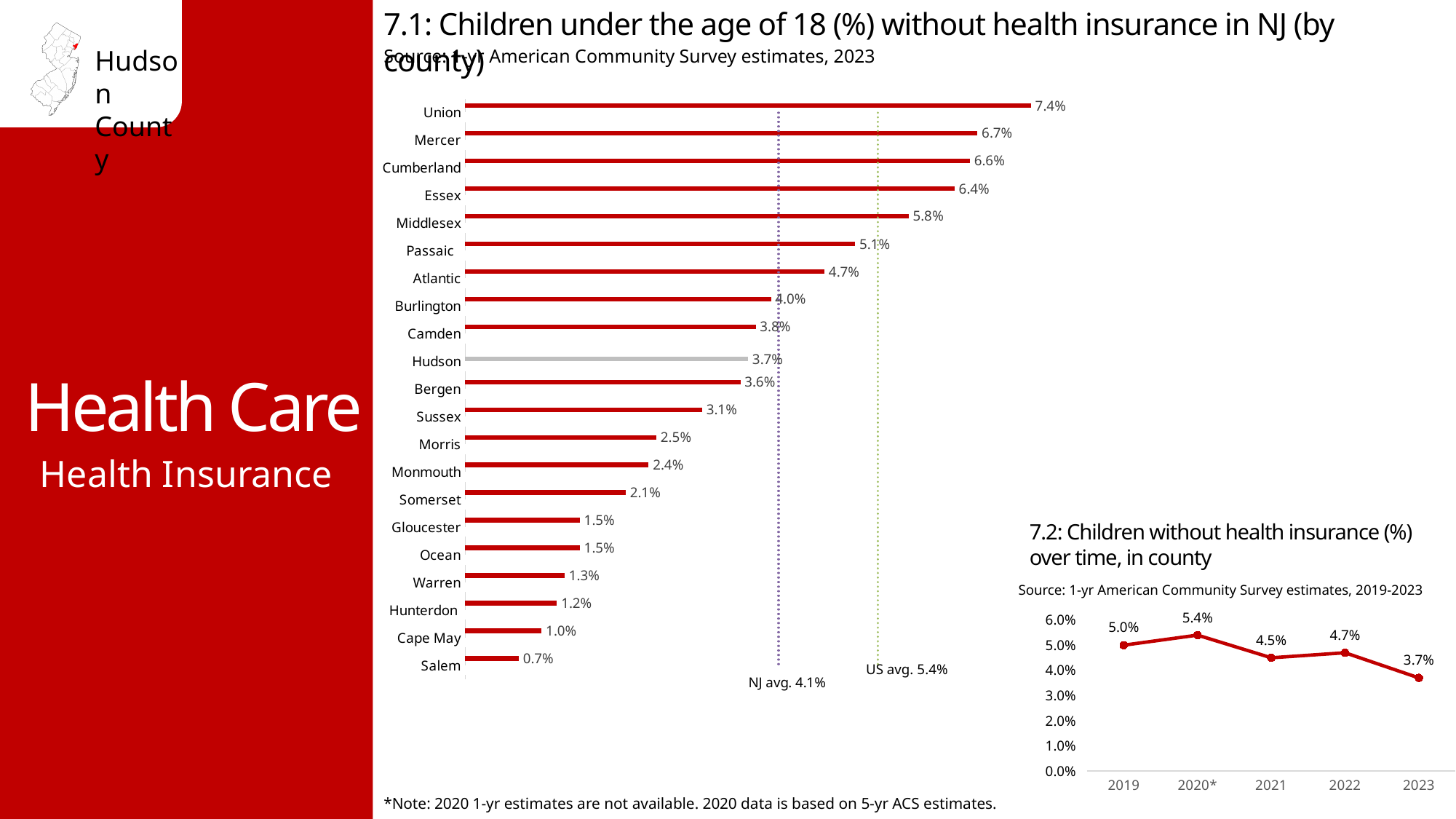
In chart 7.1, which county has the lowest percentage of children without health insurance? Salem In chart 7.1, which county has the highest percentage of children without health insurance? Union What kind of chart is chart 7.1? Bar chart In chart 7.1, what is the value for Passaic? 5.1% In chart 7.1 (children under 18 without health insurance by county), what is the value for Hudson? 3.7% In chart 7.2 (children without health insurance over time in county), what is the value for 2021? 4.5% In chart 7.1, what is the difference between the values for Union and Salem? 6.7% In chart 7.1, what NJ average value is marked by the dotted reference line? 4.1% In chart 7.1, which county has a larger value, Essex or Middlesex? Essex In chart 7.2, which year has the highest value? 2020* In chart 7.1, how many counties are shown? 21 In chart 7.2, what is the difference between the 2019 and 2023 values? 1.3%